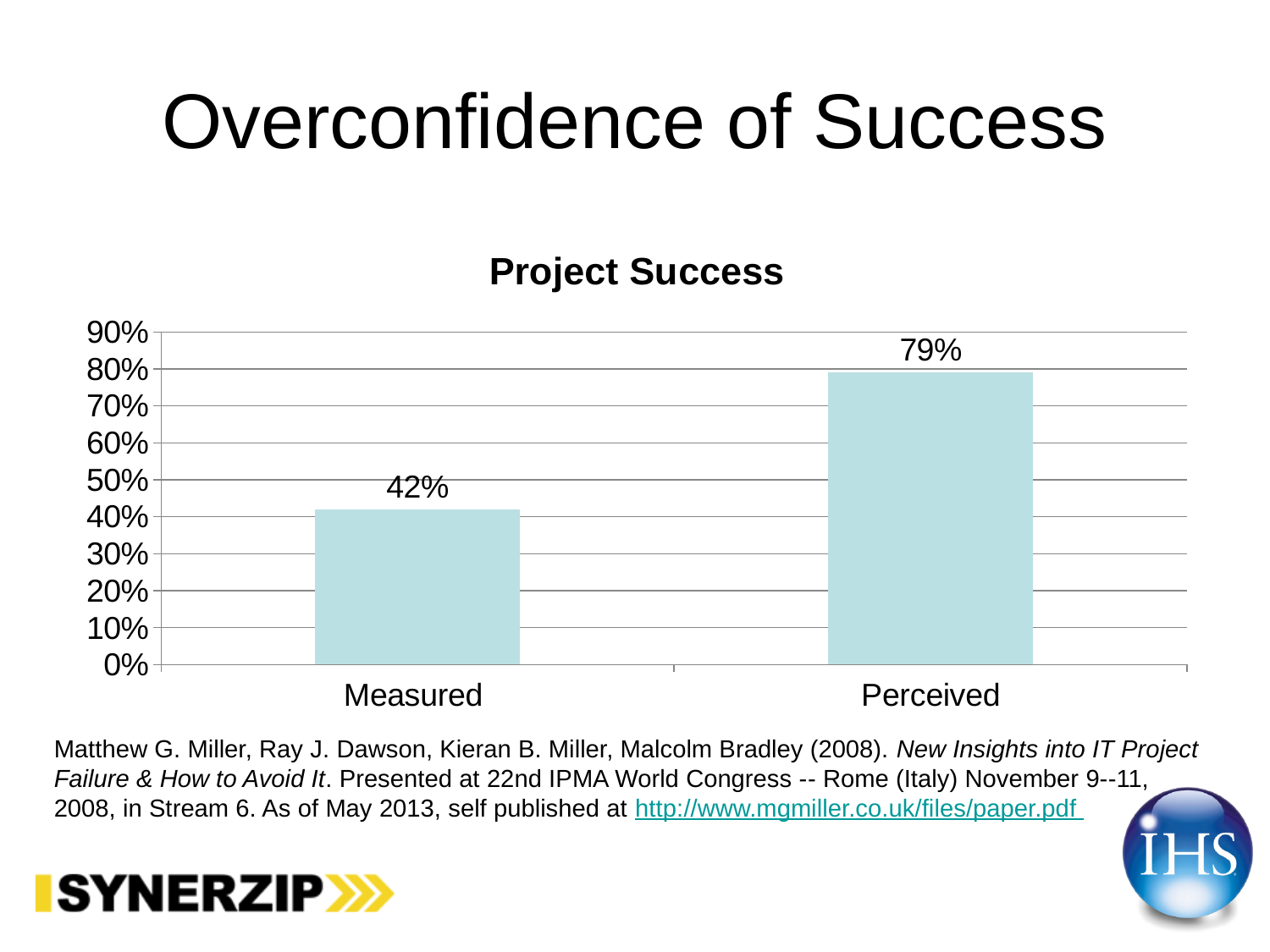
What is the title of the chart? Project Success What is the value for Perceived? 79% Is the value for Perceived greater or less than 70%? greater What kind of chart is shown on the slide? bar chart What is the value for Measured? 42% How many categories are shown on the x axis? 2 What is the highest value shown on the y axis? 90% Which is larger, the value for Measured or the value for Perceived? Perceived What is the difference between the Perceived and Measured values? 37% Which category has the highest value? Perceived Which category has the lowest value? Measured Is the value for Measured greater or less than 50%? less